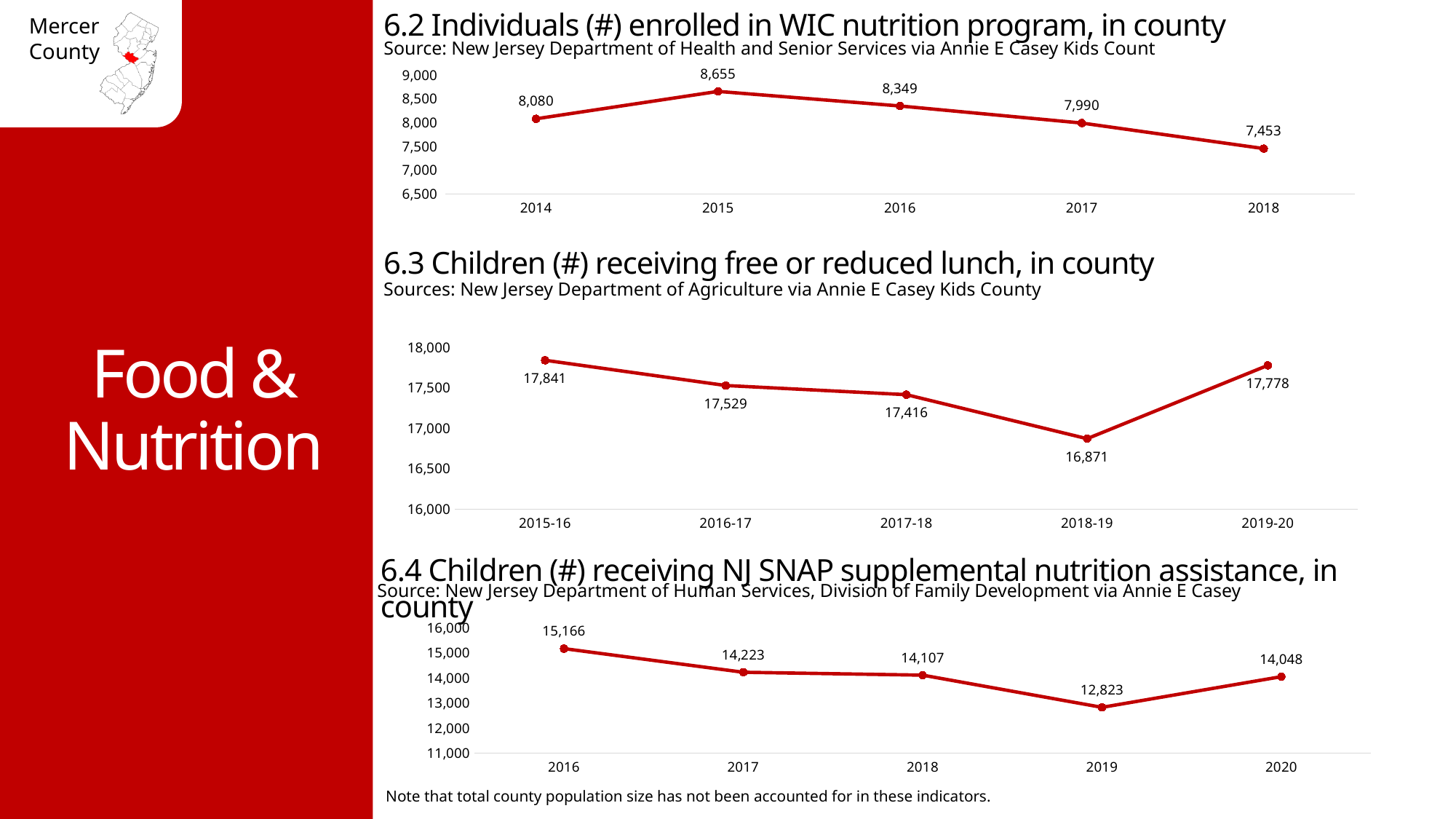
In the chart '6.2 Individuals (#) enrolled in WIC nutrition program, in county', what is the difference between the 2015 and 2018 values? 1,202 In the chart '6.2 Individuals (#) enrolled in WIC nutrition program, in county', how many data points are plotted? 5 In the chart '6.3 Children (#) receiving free or reduced lunch, in county', which school year has the highest value? 2015-16 In the chart '6.4 Children (#) receiving NJ SNAP supplemental nutrition assistance, in county', do the values rise or fall from 2016 to 2019? Fall In the chart '6.3 Children (#) receiving free or reduced lunch, in county', what is the value for 2018-19? 16,871 In the chart '6.2 Individuals (#) enrolled in WIC nutrition program, in county', which year has the lowest value? 2018 In the chart '6.3 Children (#) receiving free or reduced lunch, in county', which is larger, the value for 2016-17 or the value for 2019-20? 2019-20 In the chart '6.4 Children (#) receiving NJ SNAP supplemental nutrition assistance, in county', what is the value for 2016? 15,166 What kind of chart is '6.3 Children (#) receiving free or reduced lunch, in county'? Line chart In the chart '6.4 Children (#) receiving NJ SNAP supplemental nutrition assistance, in county', which year has the lowest value? 2019 In the chart '6.4 Children (#) receiving NJ SNAP supplemental nutrition assistance, in county', what is the difference between the 2016 and 2019 values? 2,343 In the chart '6.2 Individuals (#) enrolled in WIC nutrition program, in county', what is the value for 2015? 8,655